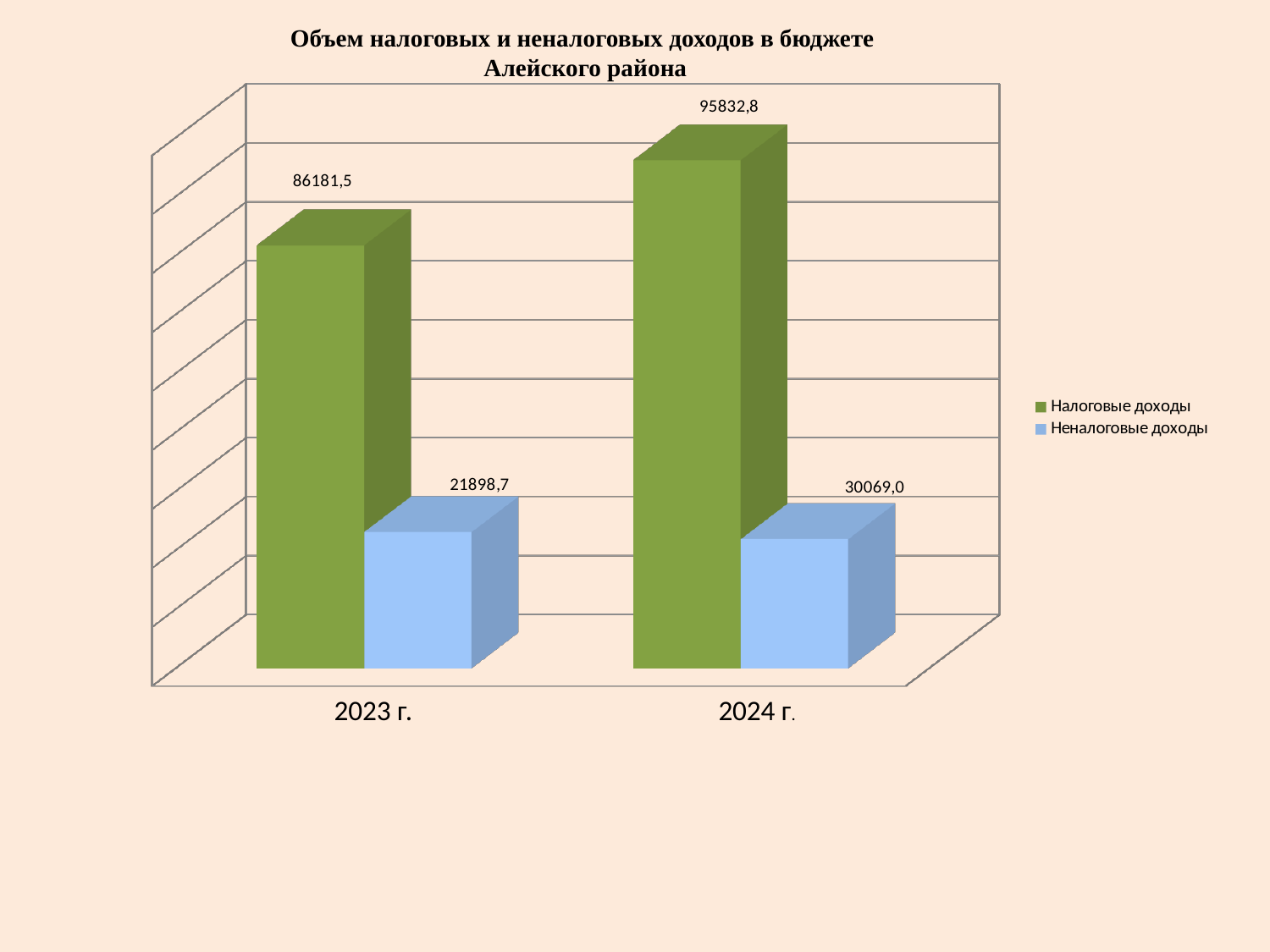
In which year is Неналоговые доходы lowest? 2023 г. What is the value of Неналоговые доходы for 2023 г.? 21898,7 How many series does the legend list? 2 What is the value of Налоговые доходы for 2023 г.? 86181,5 What is the value of Неналоговые доходы for 2024 г.? 30069,0 In which year is Налоговые доходы highest? 2024 г. Which is larger in 2024 г.: Налоговые доходы or Неналоговые доходы? Налоговые доходы What is the value of Налоговые доходы for 2024 г.? 95832,8 What kind of chart is shown on the slide? Bar chart How many years are shown on the x axis? 2 What is the difference between Налоговые доходы and Неналоговые доходы in 2023 г.? 64282,8 By how much did Налоговые доходы increase from 2023 г. to 2024 г.? 9651,3